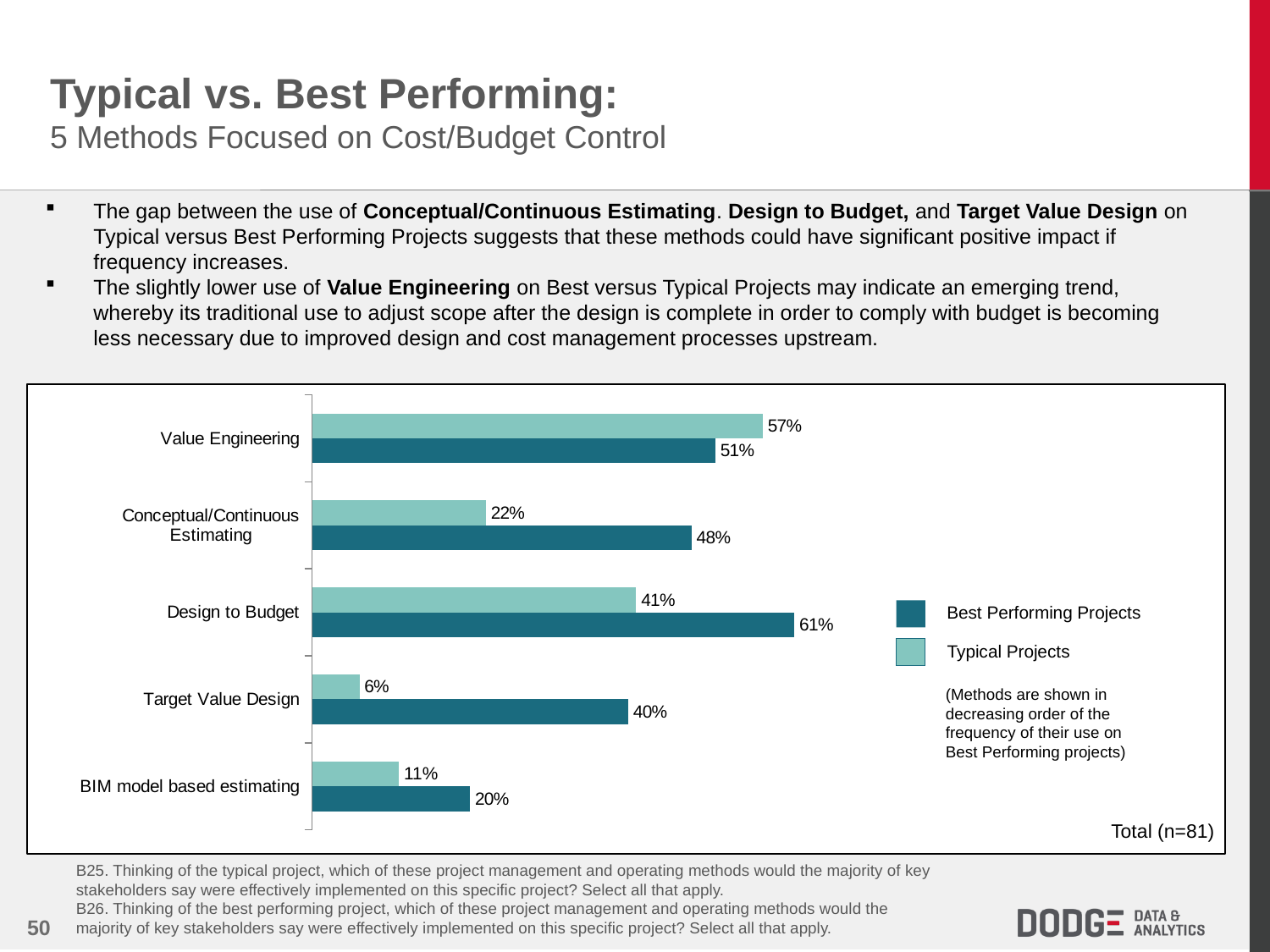
What is the sample size shown on the chart? n=81 What is the difference between Best Performing Projects and Typical Projects for Design to Budget? 20% What is the value for Typical Projects for BIM model based estimating? 11% Which method has the highest value for Best Performing Projects? Design to Budget How many series does the legend list? 2 What is the value for Best Performing Projects for Target Value Design? 40% What kind of chart is shown on the slide? Bar chart What is the value for Typical Projects for Value Engineering? 57% What is the difference between Best Performing Projects and Typical Projects for Conceptual/Continuous Estimating? 26% For Value Engineering, which is larger: the Typical Projects value or the Best Performing Projects value? Typical Projects How many methods are shown in the chart? 5 Which method has the lowest value for Typical Projects? Target Value Design